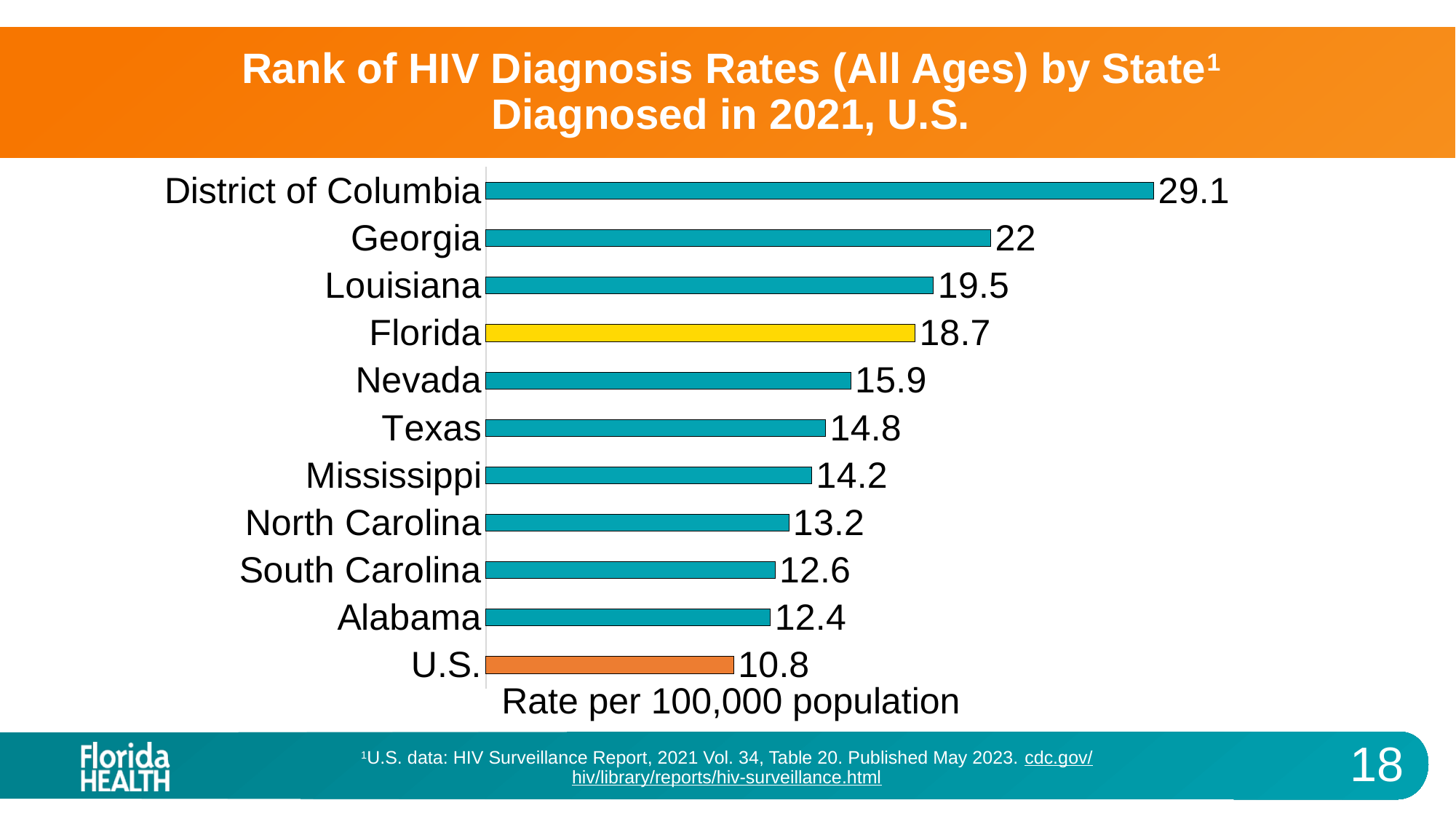
How many bars are shown in the chart? 11 What kind of chart is shown on the slide? Bar chart Which category has the lowest HIV diagnosis rate? U.S. Which category has the highest HIV diagnosis rate? District of Columbia What is the difference between the rates for Florida and the U.S.? 7.9 What is the HIV diagnosis rate for the U.S. overall? 10.8 What is the x-axis label of the chart? Rate per 100,000 population Which bar is highlighted in yellow? Florida What is the HIV diagnosis rate for Florida? 18.7 What is the difference between the rates for District of Columbia and Georgia? 7.1 Which has a higher HIV diagnosis rate, Louisiana or Nevada? Louisiana What is the HIV diagnosis rate for Georgia? 22